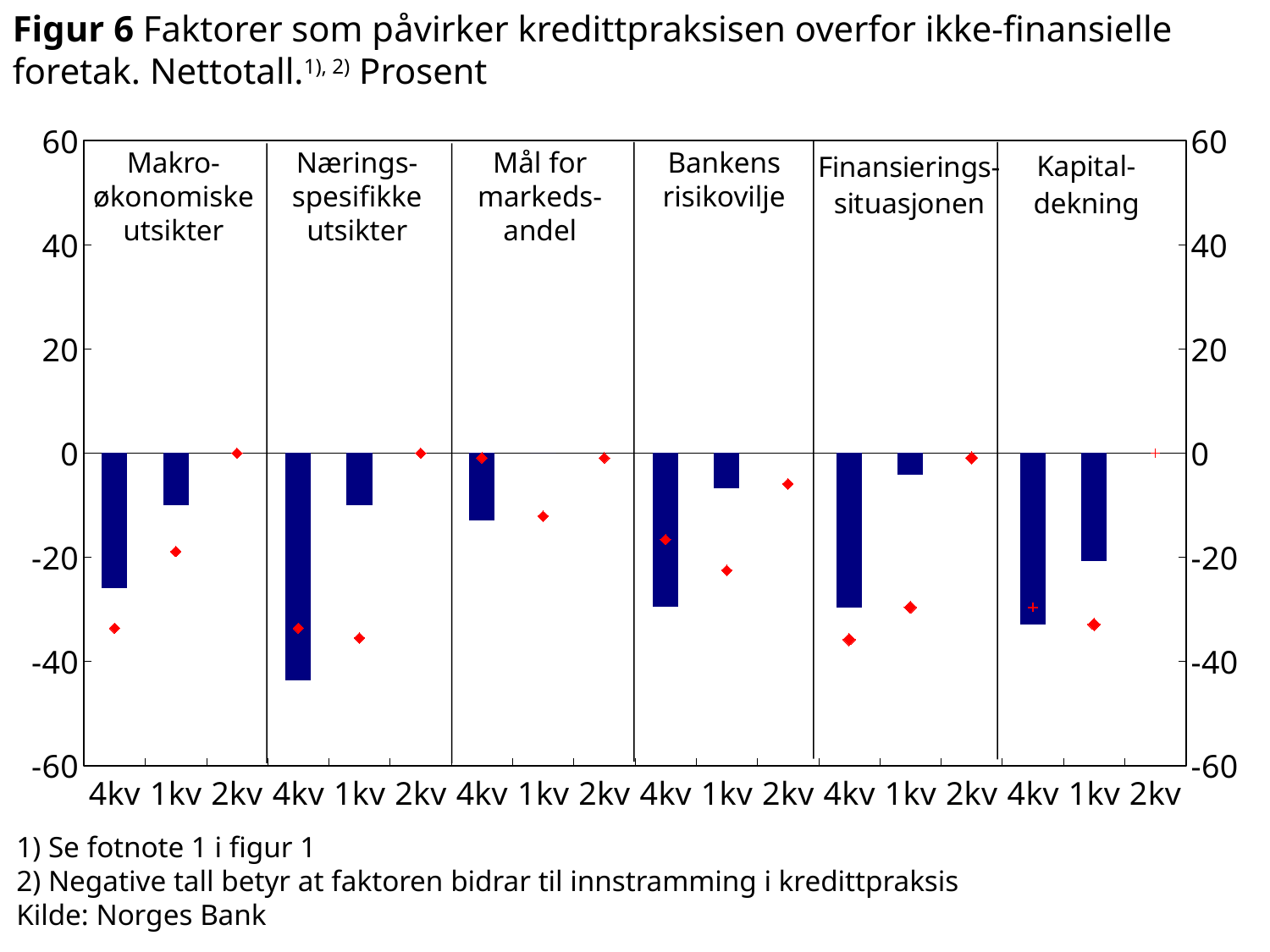
Is the 4kv bar for Kapitaldekning greater or less than -20? less Is the 4kv bar for Makroøkonomiske utsikter greater or less than -20? less What is the source given for the chart? Norges Bank Is the 1kv bar for Bankens risikovilje greater or less than -20? greater How many factors (panels) are shown in the chart? 6 Which factor has the lowest (most negative) 4kv bar? Næringsspesifikke utsikter For Makroøkonomiske utsikter, do the bars rise or fall from 4kv to 2kv? rise What kind of chart is shown in Figur 6? bar chart How many quarters are shown on the x axis within each panel? 3 For Makroøkonomiske utsikter, which bar is lower, 4kv or 1kv? 4kv